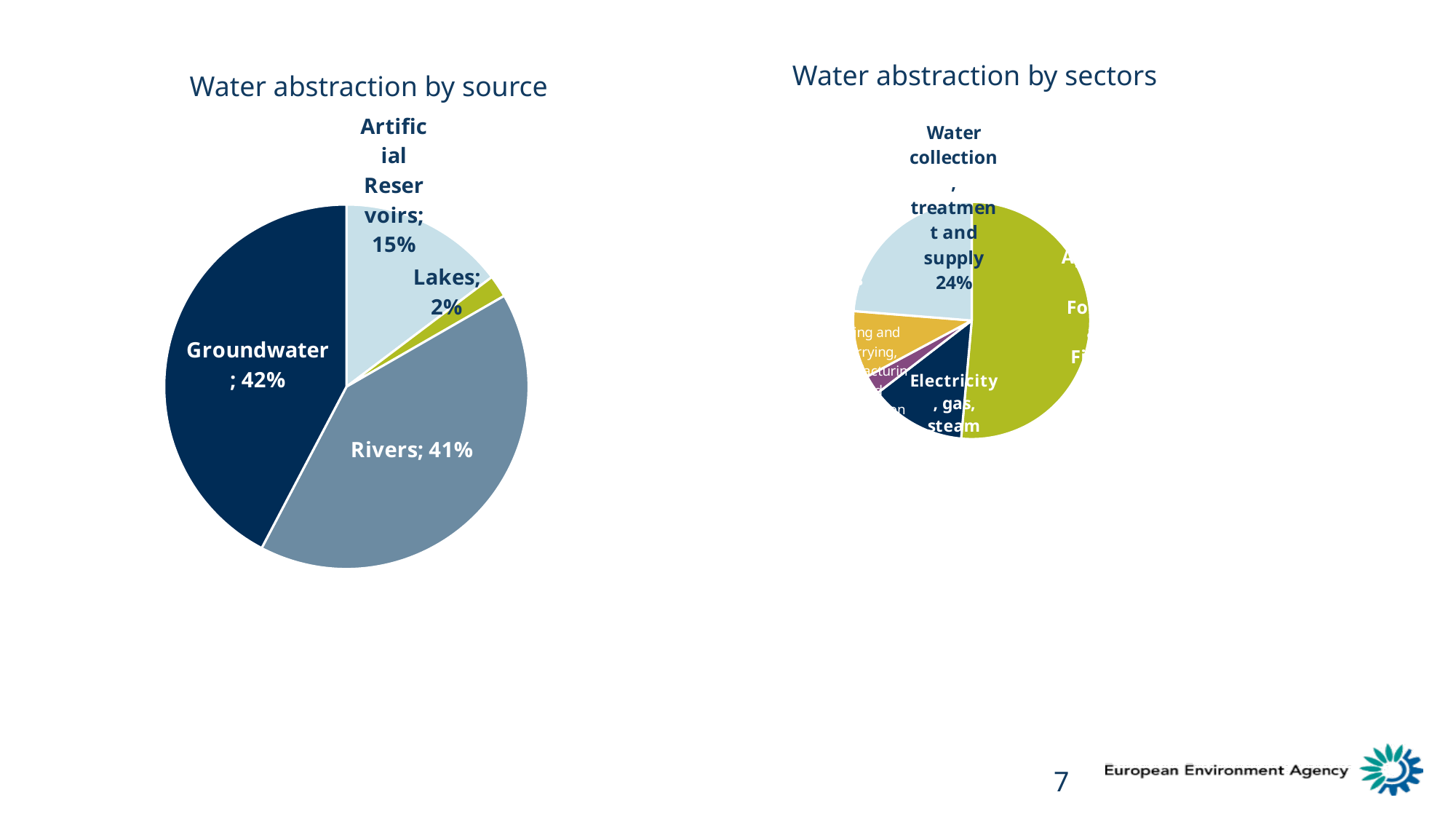
In the 'Water abstraction by source' chart, what share do Lakes have? 2% How many slices does the 'Water abstraction by source' chart have? 4 In the 'Water abstraction by source' chart, which source has the largest share? Groundwater What is the title of the chart on the right side of the slide? Water abstraction by sectors In the 'Water abstraction by source' chart, what share does Groundwater have? 42% In the 'Water abstraction by source' chart, what share do Artificial Reservoirs have? 15% In the 'Water abstraction by source' chart, what is the difference in percentage points between Groundwater and Rivers? 1 percentage point In the 'Water abstraction by source' chart, which is larger: Artificial Reservoirs or Lakes? Artificial Reservoirs What type of chart is the 'Water abstraction by source' chart? Pie chart In the 'Water abstraction by sectors' chart, what share does 'Water collection, treatment and supply' have? 24% In the 'Water abstraction by source' chart, which source has the smallest share? Lakes In the 'Water abstraction by source' chart, what share does Rivers have? 41%